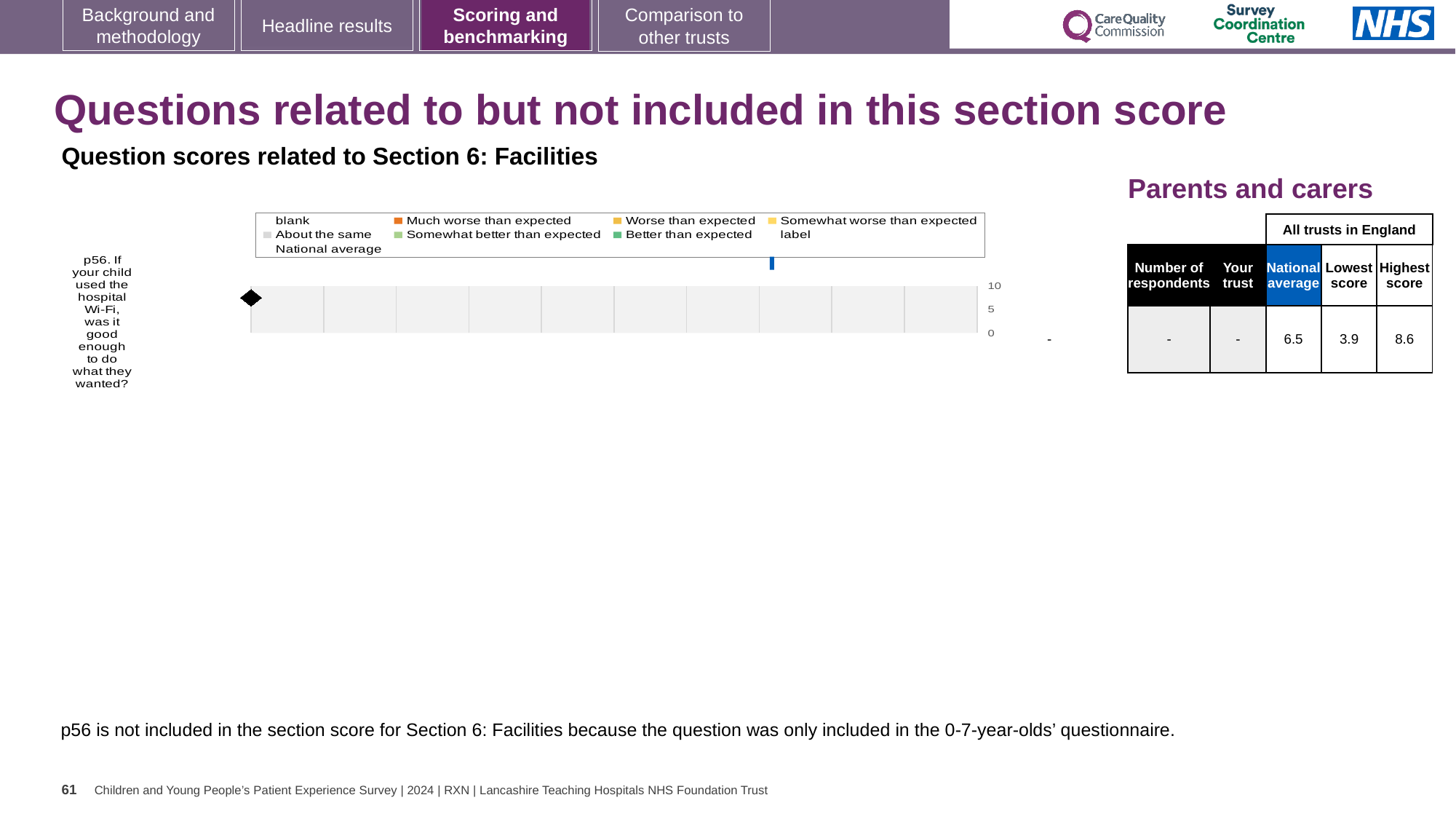
Which question number is plotted in the chart? p56 In the table, what is the highest score across all trusts in England for p56? 8.6 How many entries does the chart legend list? 9 What value is shown for 'Your trust' for p56 in the table? - Is the national average score for p56 greater or less than 5? greater In the table, what is the lowest score across all trusts in England for p56? 3.9 Which is larger for p56: the national average or the lowest score? national average How many questions (categories) are plotted in the chart? 1 In the table, what is the national average score for p56? 6.5 What is the highest value shown on the chart's vertical axis? 10 What kind of chart is shown on the slide? bar chart What is the difference between the highest score and the lowest score for p56 in the table? 4.7